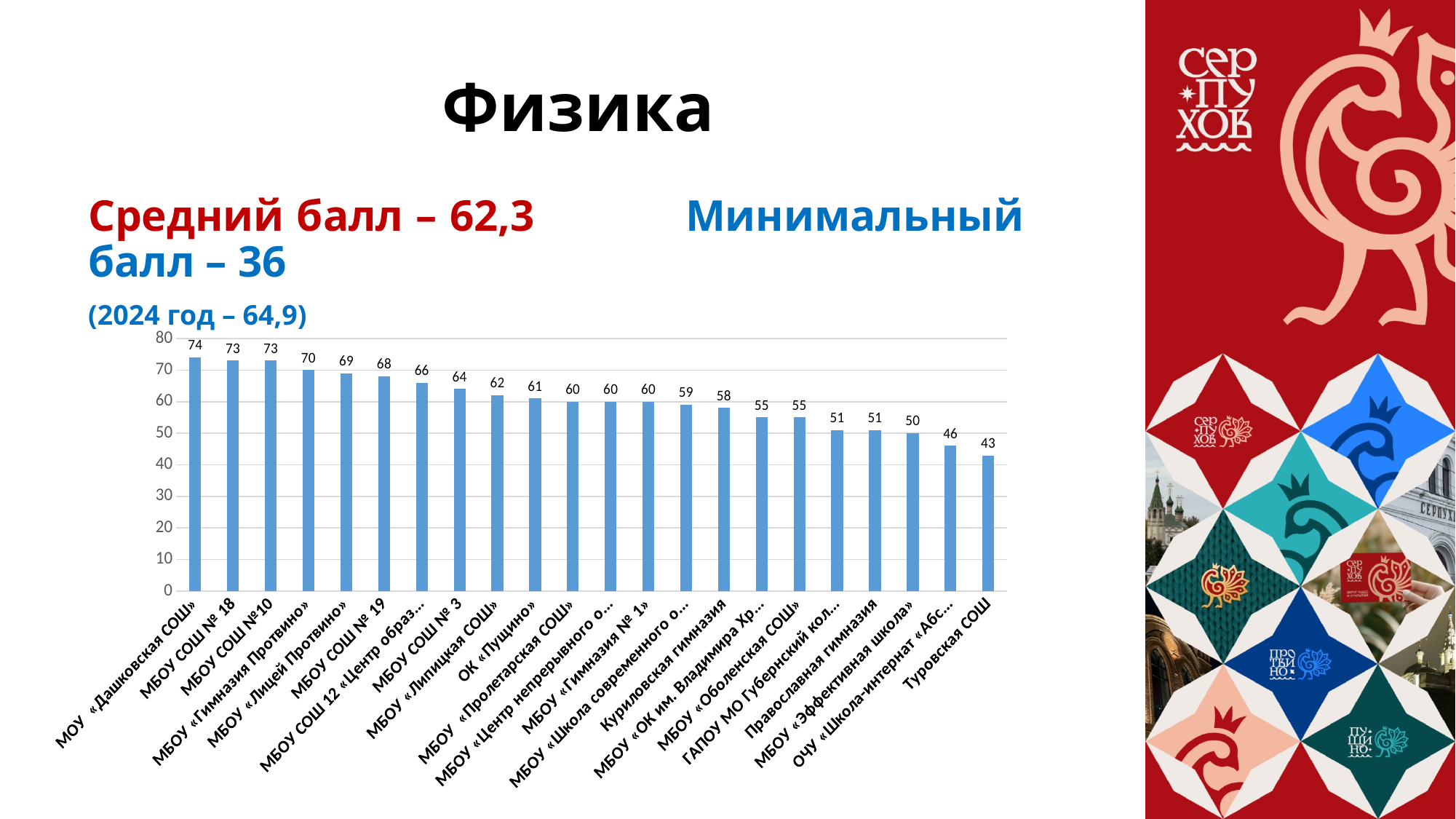
Which category has the highest value? МОУ «Дашковская СОШ» Which is larger, the value for МБОУ «Гимназия Протвино» or the value for МБОУ СОШ № 19? МБОУ «Гимназия Протвино» What is the value for МБОУ «Эффективная школа»? 50 What is the difference between the values for МОУ «Дашковская СОШ» and Туровская СОШ? 31 What is the value for Куриловская гимназия? 58 How many bars are plotted in the chart? 22 Do the values rise or fall from left to right along the x axis? fall What is the value for Туровская СОШ? 43 What is the title of the slide containing the chart? Физика What type of chart is shown on the slide? bar chart Which category has the lowest value? Туровская СОШ What is the value for МОУ «Дашковская СОШ»? 74